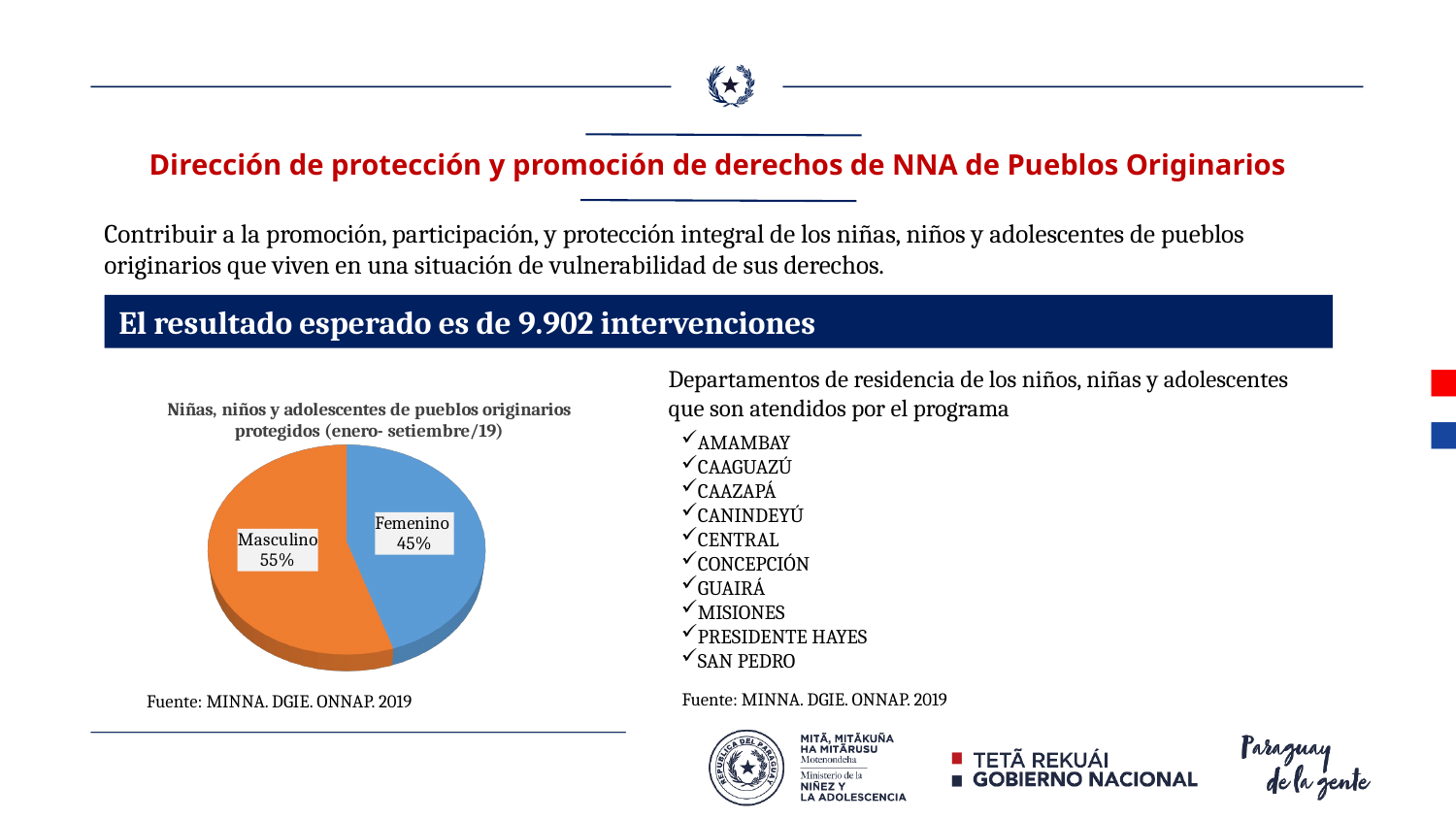
Which slice of the pie is the largest? Masculino Which slice of the pie is the smallest? Femenino What share of the pie does Masculino represent? 55% How many slices does the pie chart have? 2 What colour is the Femenino slice of the pie chart? blue Which is larger, the Masculino slice or the Femenino slice? Masculino What is the title of the pie chart? Niñas, niños y adolescentes de pueblos originarios protegidos (enero- setiembre/19) Is the share for Femenino greater or less than 50%? less What is the difference in percentage points between the Masculino and Femenino slices? 10 What kind of chart is shown on the slide? pie chart What share of the pie does Femenino represent? 45%